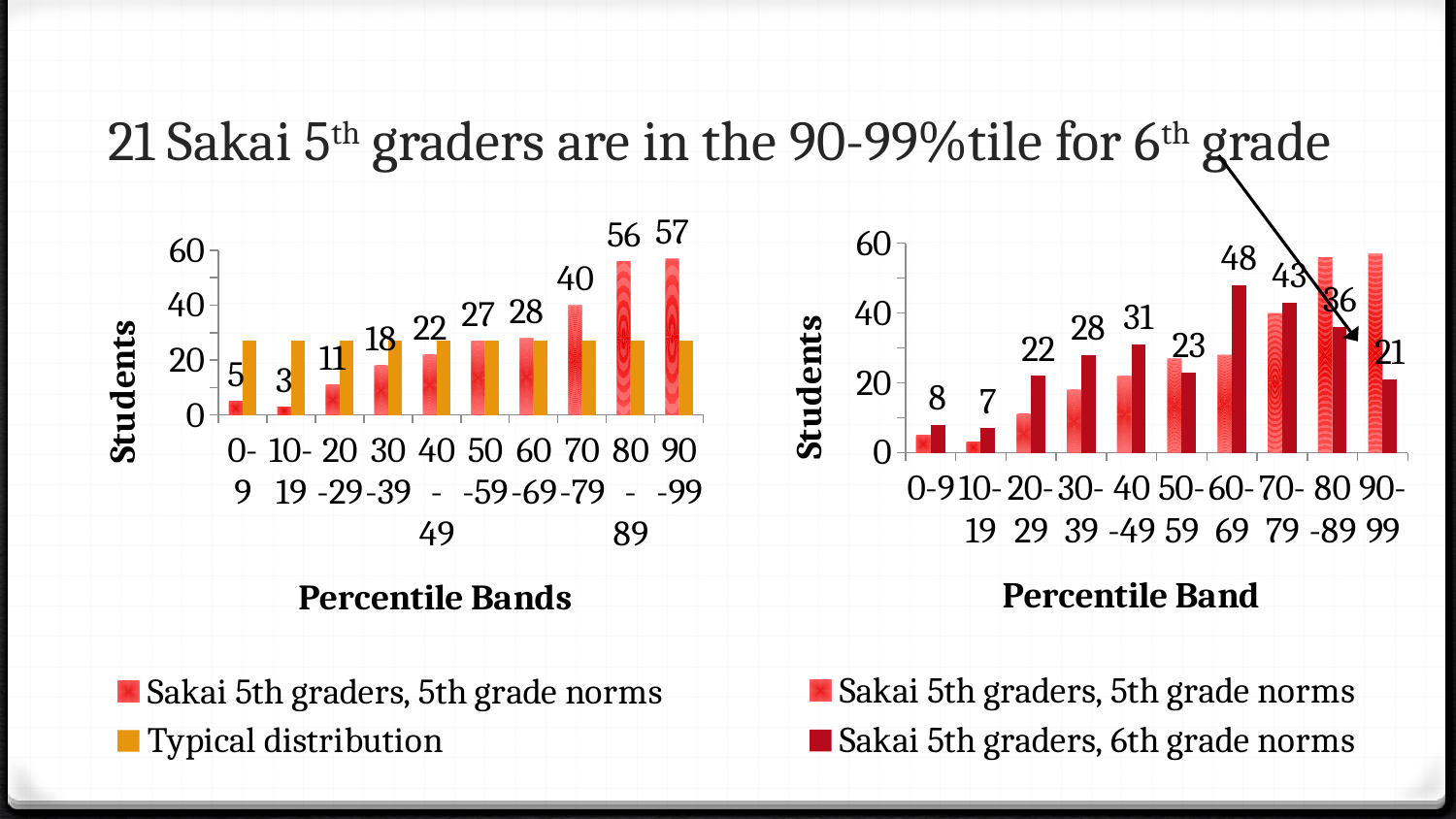
How many percentile bands are shown on the x axis of the right chart? 10 In the right chart, which percentile band has the highest value for Sakai 5th graders, 6th grade norms? 60-69 In the left chart, what is the difference between the Sakai 5th graders (5th grade norms) values for the 90-99 and 70-79 percentile bands? 17 In the left chart, what is the value for Sakai 5th graders, 5th grade norms in the 10-19 percentile band? 3 In the left chart, which percentile band has the highest value for Sakai 5th graders, 5th grade norms? 90-99 What type of chart is the left chart? Bar chart In the right chart, which is larger for Sakai 5th graders, 6th grade norms: the 30-39 band or the 50-59 band? 30-39 In the left chart, which percentile band has the lowest value for Sakai 5th graders, 5th grade norms? 10-19 In the right chart, how many Sakai 5th graders are in the 90-99 percentile band under 6th grade norms? 21 In the right chart, what is the difference between the 6th grade norms values for the 60-69 and 70-79 percentile bands? 5 In the left chart, is the Typical distribution value for the 0-9 percentile band greater or less than 20? greater In the left chart, how many Sakai 5th graders (5th grade norms) are in the 80-89 percentile band? 56